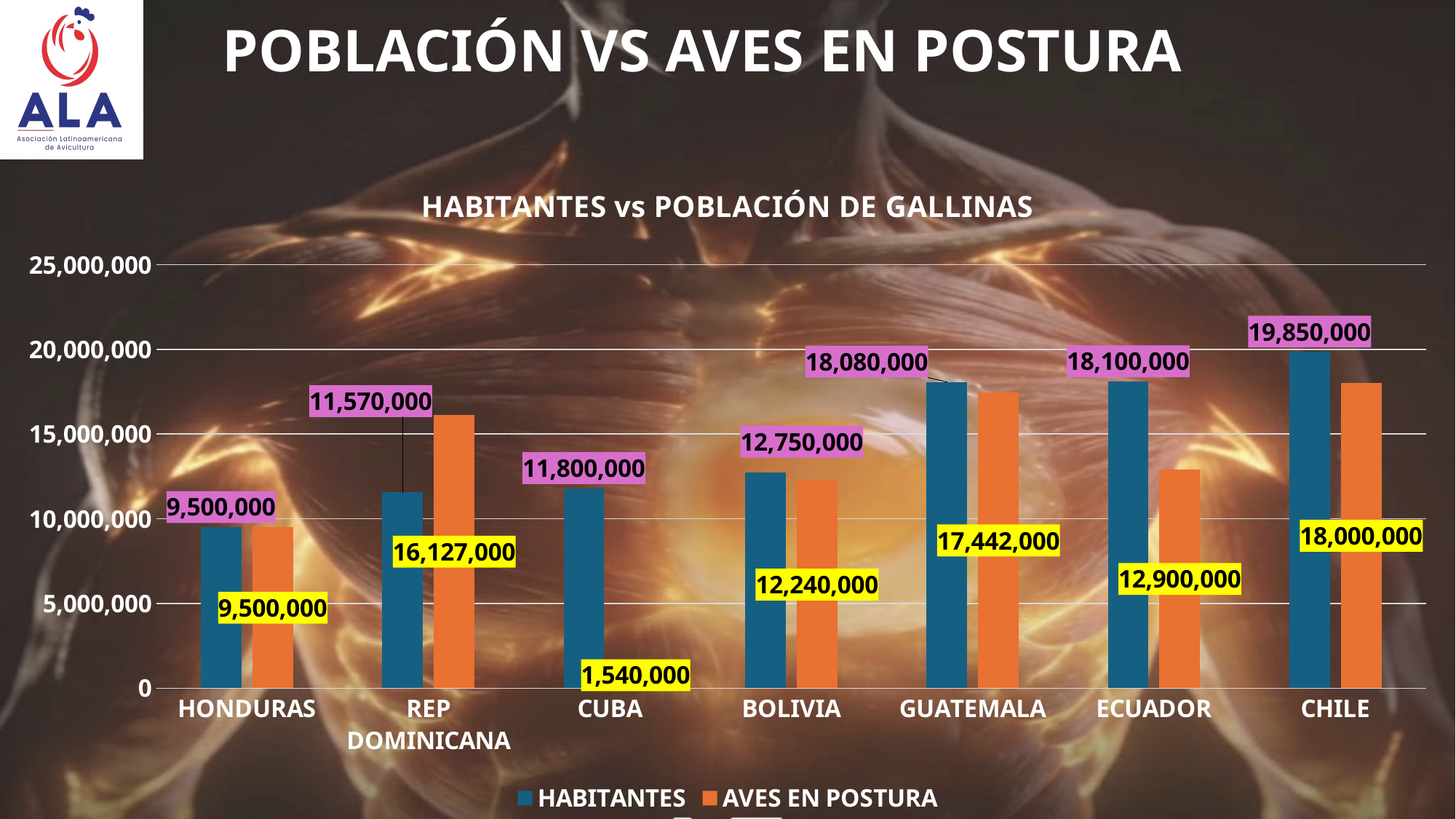
What kind of chart is shown? bar chart Which country has the lowest AVES EN POSTURA value? CUBA How many series does the legend list? 2 What is the HABITANTES value for CHILE? 19,850,000 What is the AVES EN POSTURA value for REP DOMINICANA? 16,127,000 What is the AVES EN POSTURA value for CUBA? 1,540,000 What is the title of the chart? HABITANTES vs POBLACIÓN DE GALLINAS How many countries are shown on the x axis? 7 For REP DOMINICANA, which is larger: HABITANTES or AVES EN POSTURA? AVES EN POSTURA What is the difference between HABITANTES and AVES EN POSTURA for ECUADOR? 5,200,000 Which country has the highest HABITANTES value? CHILE Is the AVES EN POSTURA value for GUATEMALA greater or less than 15,000,000? greater